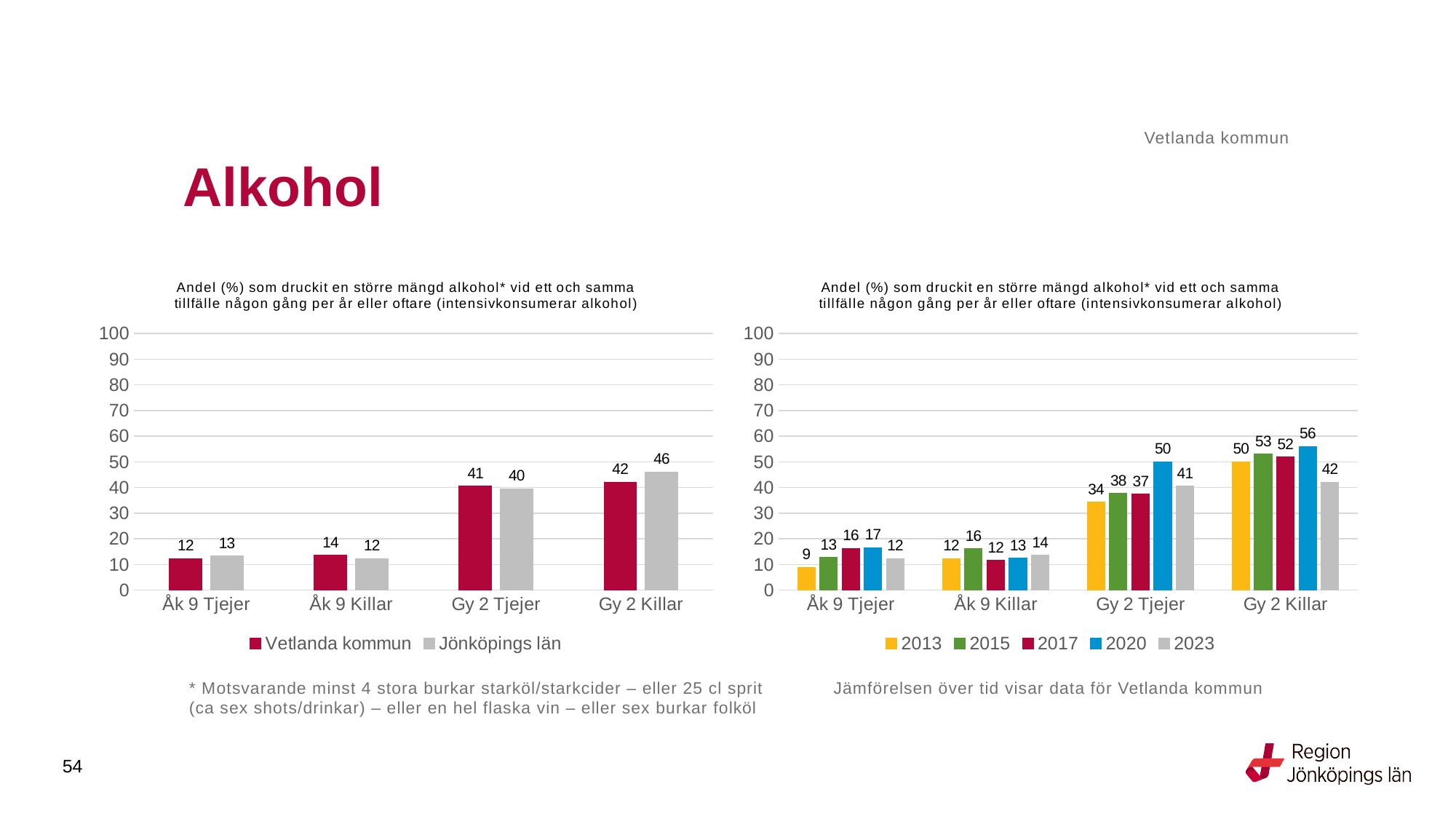
In the left chart, which is larger for Åk 9 Killar: Vetlanda kommun or Jönköpings län? Vetlanda kommun In the right chart, what is the value for 2013 for Åk 9 Tjejer? 9 In the left chart, which category has the highest value for Jönköpings län? Gy 2 Killar In the left chart, what is the difference between Vetlanda kommun and Jönköpings län for Gy 2 Killar? 4 In the right chart, what is the difference between 2020 and 2023 for Gy 2 Killar? 14 In the right chart, what is the value for 2020 for Gy 2 Killar? 56 In the left chart, what is the value for Vetlanda kommun for Gy 2 Killar? 42 In the right chart, which year has the lowest value for Gy 2 Tjejer? 2013 How many series does the legend of the right chart list? 5 In the left chart, what is the value for Jönköpings län for Åk 9 Tjejer? 13 How many series does the legend of the left chart list? 2 What kind of chart is the right chart? Bar chart